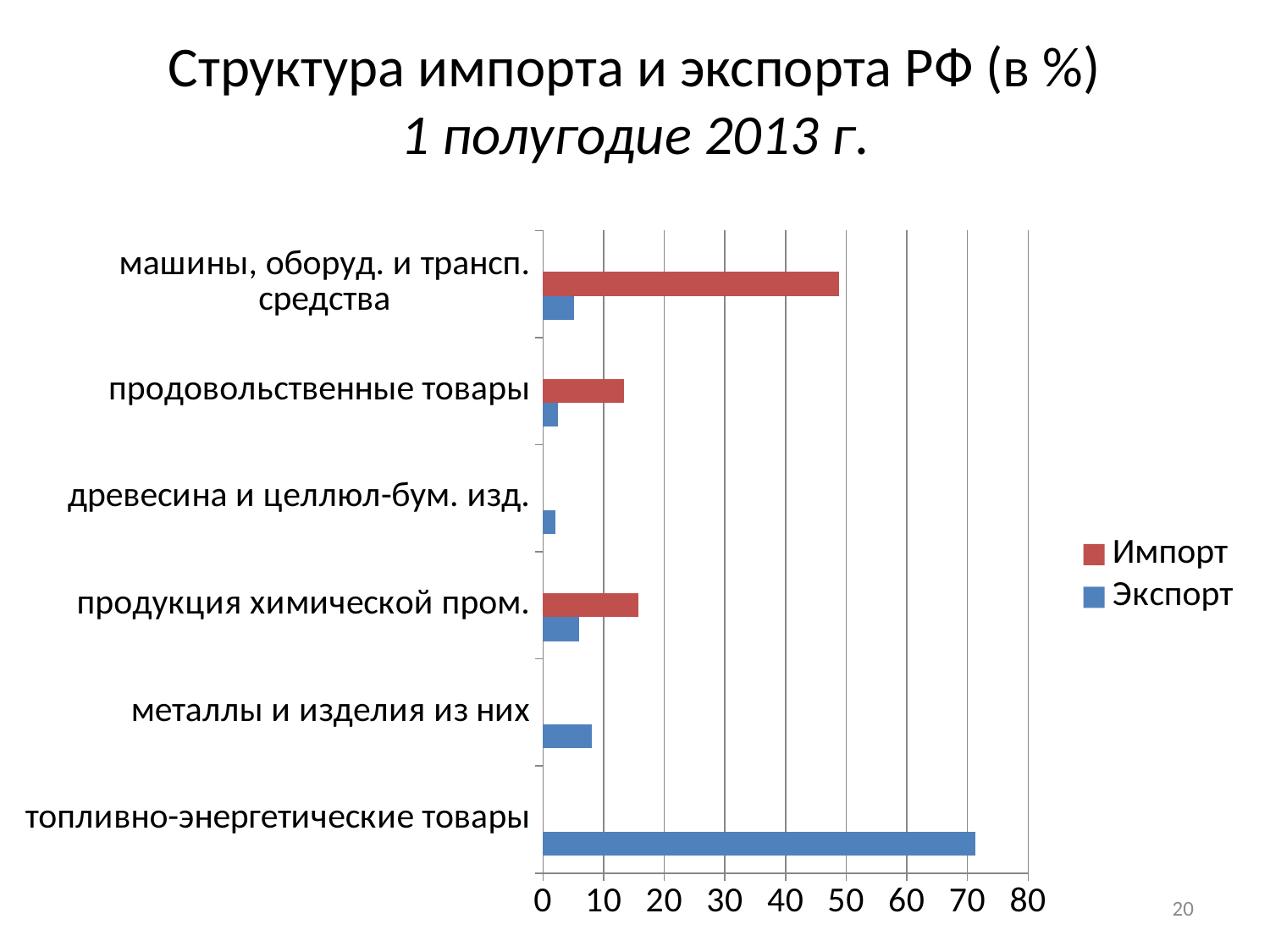
Which is larger: the Импорт value for продукция химической пром. or the Импорт value for продовольственные товары? продукция химической пром. Which colour represents the Экспорт series in the legend? blue Is the Экспорт value for топливно-энергетические товары greater or less than 70? greater Is the Экспорт value for металлы и изделия из них greater or less than 10? less Is the Импорт value for машины, оборуд. и трансп. средства greater or less than 50? less For машины, оборуд. и трансп. средства, which is larger: Импорт or Экспорт? Импорт How many series does the legend list? 2 Which category has the highest Экспорт value? топливно-энергетические товары How many categories are shown on the chart? 6 What kind of chart is shown on the slide? bar chart Which category has the highest Импорт value? машины, оборуд. и трансп. средства